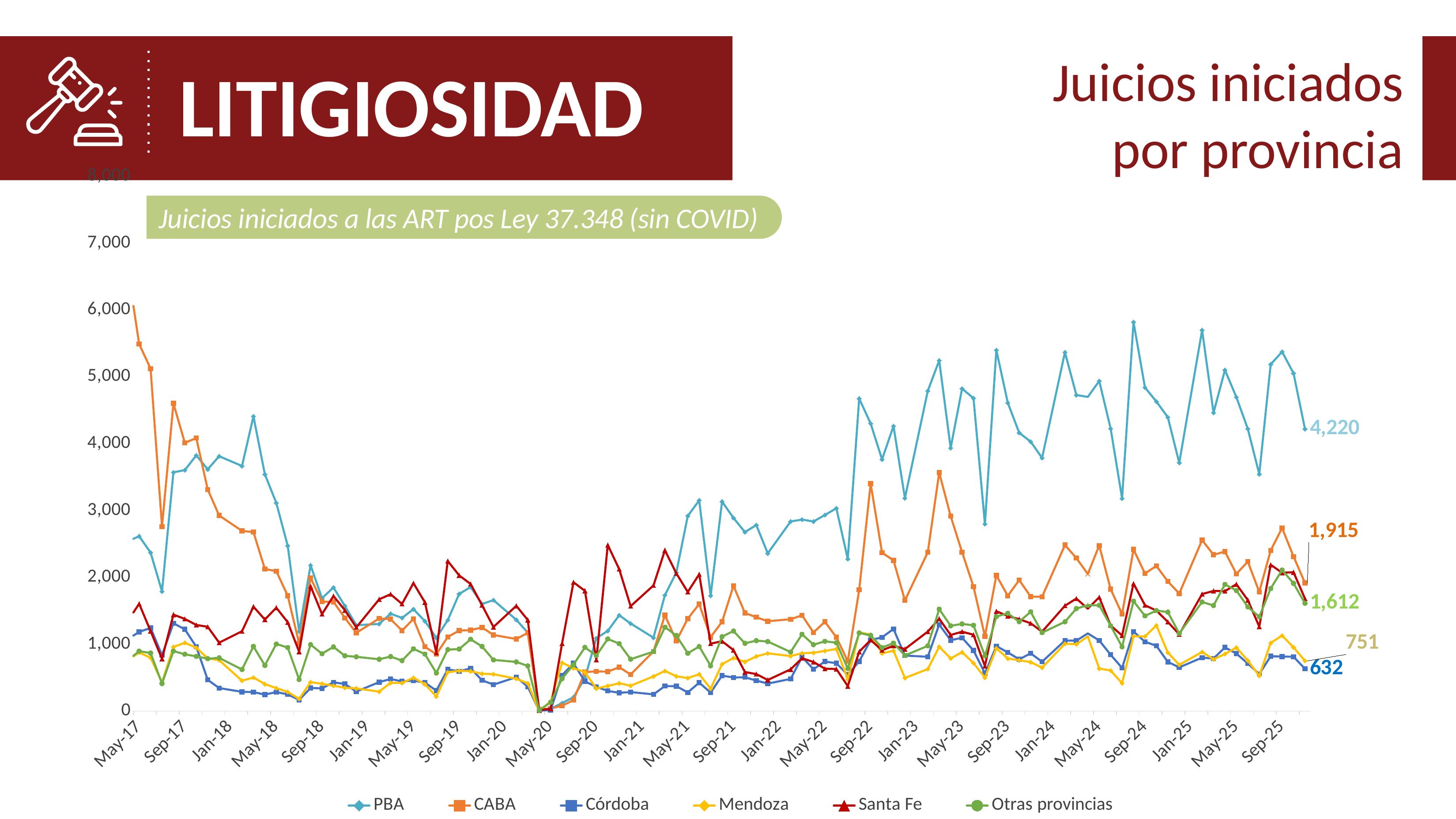
Is the value for CABA at May-17 greater or less than 5,000? greater Which series has the highest final labelled value? PBA How many series does the legend list? 6 Does the CABA line rise or fall between May-17 and Jan-18? fall What is the final labelled value for CABA? 1,915 What is the final labelled value for Mendoza? 751 What is the final labelled value for Córdoba? 632 What kind of chart is shown on the slide? line chart What is the final labelled value for PBA? 4,220 What is the final labelled value for Otras provincias? 1,612 What is the difference between the final labelled values of PBA and CABA? 2,305 What is the subtitle shown in the green box above the chart? Juicios iniciados a las ART pos Ley 37.348 (sin COVID)